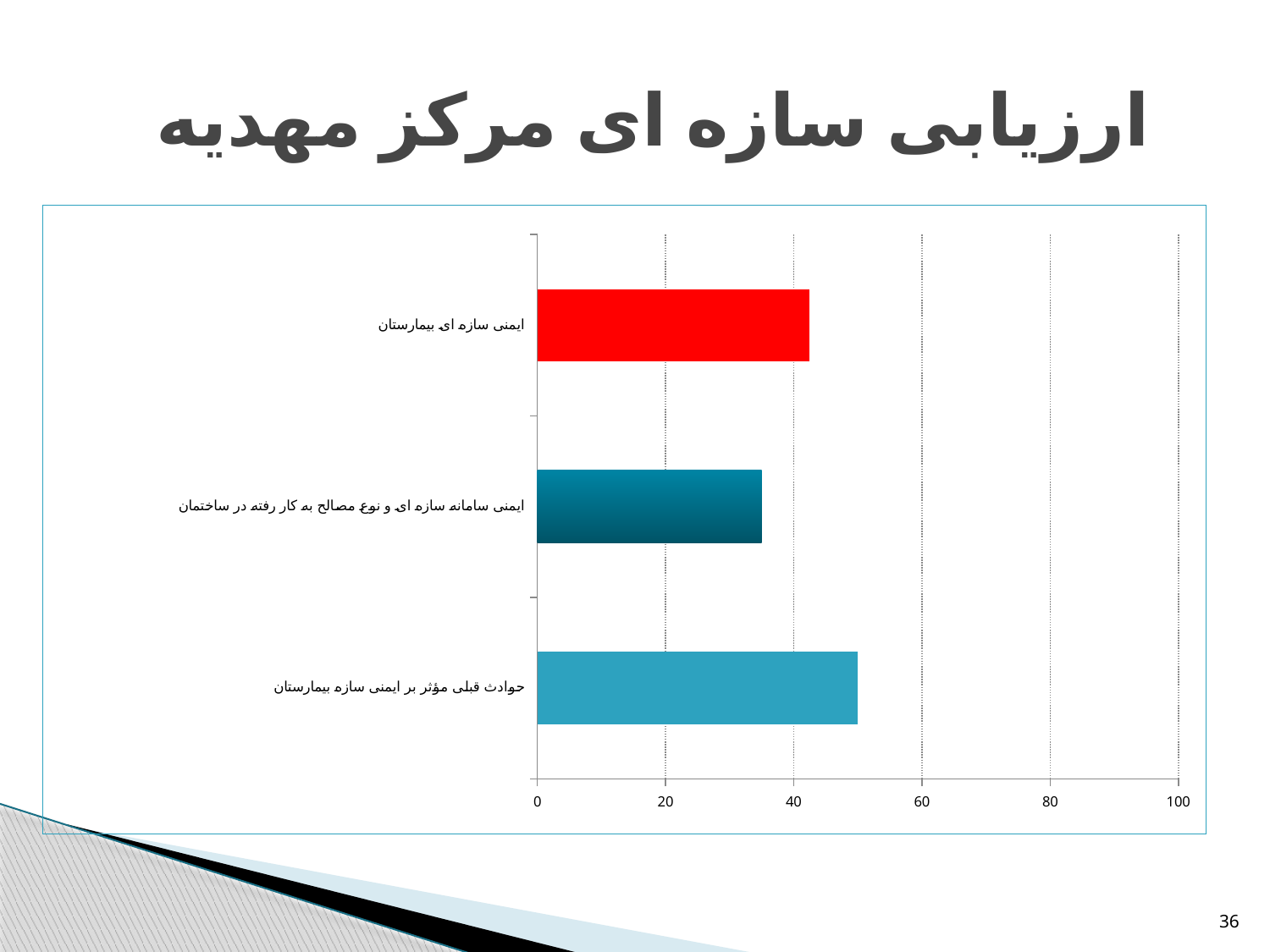
Which category has the lowest value in the chart? ایمنی سامانه سازه ای و نوع مصالح به کار رفته در ساختمان Which is larger: the value for ایمنی سازه ای بیمارستان or the value for ایمنی سامانه سازه ای و نوع مصالح به کار رفته در ساختمان? ایمنی سازه ای بیمارستان Is the value for ایمنی سامانه سازه ای و نوع مصالح به کار رفته در ساختمان greater or less than 40? less Is the value for حوادث قبلی مؤثر بر ایمنی سازه بیمارستان greater or less than 60? less Is the value for حوادث قبلی مؤثر بر ایمنی سازه بیمارستان greater or less than 40? greater Which category has the highest value in the chart? حوادث قبلی مؤثر بر ایمنی سازه بیمارستان What is the title of the slide containing the chart? ارزیابی سازه ای مرکز مهدیه Which is larger: the value for حوادث قبلی مؤثر بر ایمنی سازه بیمارستان or the value for ایمنی سازه ای بیمارستان? حوادث قبلی مؤثر بر ایمنی سازه بیمارستان What colour is the bar for ایمنی سازه ای بیمارستان? red How many categories are plotted in the chart? 3 What kind of chart is shown on the slide? bar chart